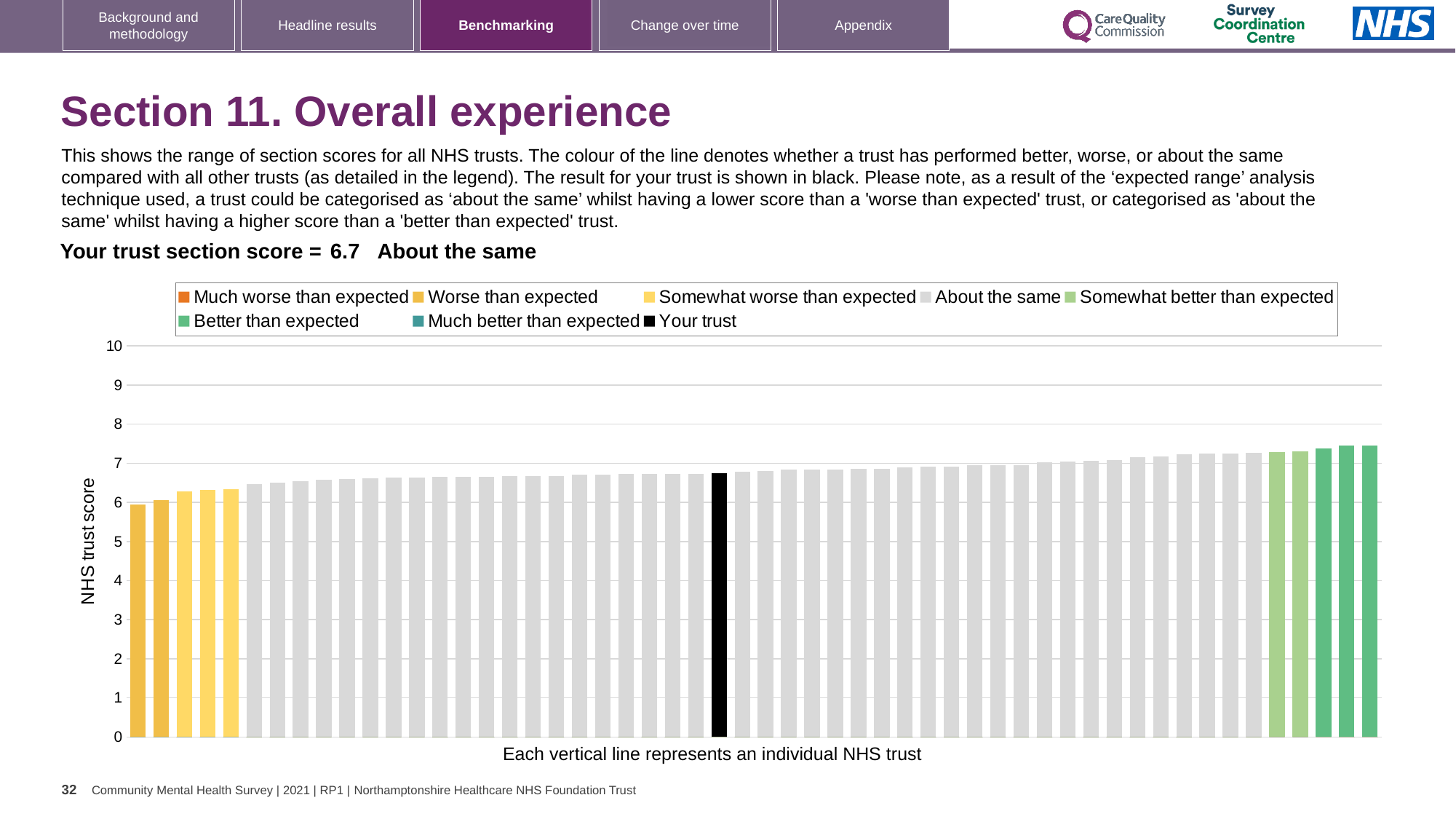
Is the value of the tallest bar greater or less than 7? greater What kind of chart is shown on the slide? bar chart What is the section score for your trust? 6.7 Is the value of the tallest bar greater or less than 8? less How many entries does the chart legend list? 8 Which legend category do the tallest bars on the right belong to? Better than expected How is your trust categorised compared with other trusts for this section? About the same Is the value of the shortest bar greater or less than 5? greater What colour is the bar representing your trust? black What is the label of the vertical axis? NHS trust score Do the bar values rise or fall from left to right along the x axis? rise